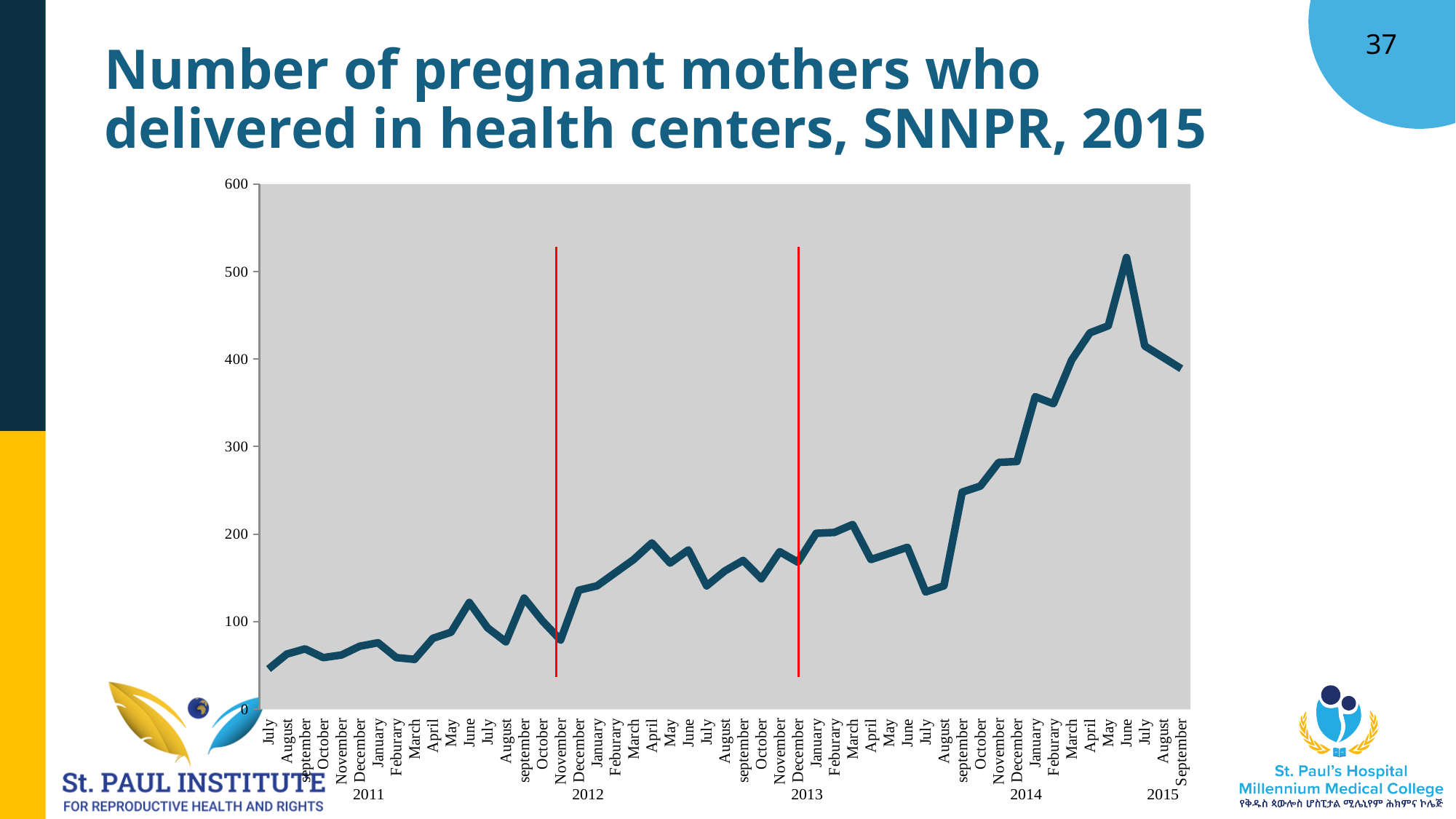
Overall, do the values rise or fall from July 2011 to September 2015? rise Is the value for July 2011 greater or less than 100? less What is the title of the chart? Number of pregnant mothers who delivered in health centers, SNNPR, 2015 What kind of chart is shown on the slide? line chart In which month and year does the line reach its highest value? June 2014 How many monthly data points are plotted on the chart? 51 Is the value for August 2014 greater or less than 200? less How many red vertical lines are drawn on the chart? 2 Is the value for September 2015 greater or less than 300? greater